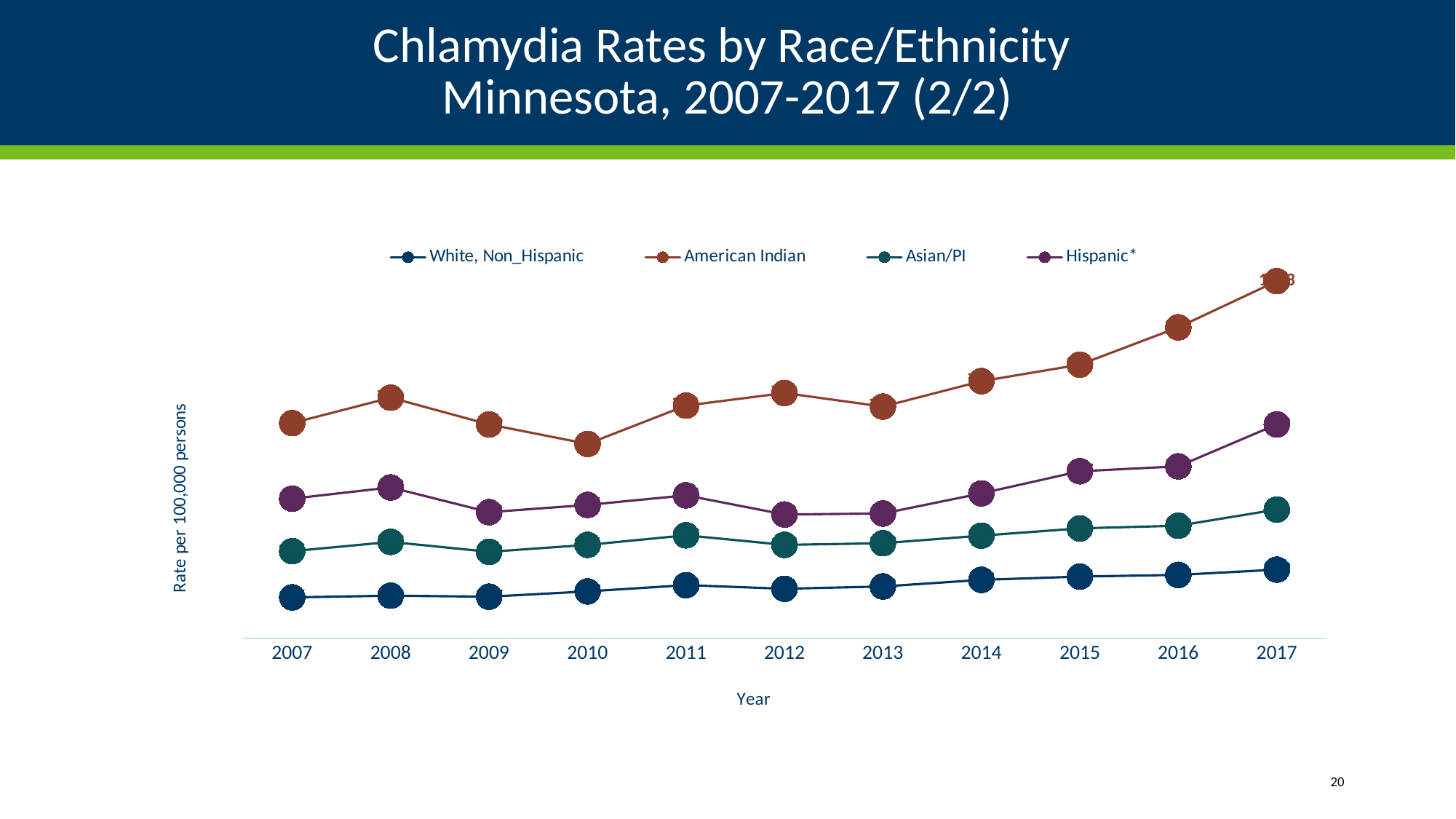
How many series does the legend list? 4 Does the American Indian rate rise or fall from 2013 to 2017? rise Which group has the lowest rate in 2010? White, Non_Hispanic In 2015, is the rate for Hispanic* higher or lower than the rate for Asian/PI? higher Which is larger for American Indian: the rate in 2017 or the rate in 2010? 2017 How many years are plotted along the x axis? 11 Which group has the highest rate in 2007? American Indian Which race/ethnicity group has the lowest chlamydia rate in 2017? White, Non_Hispanic What kind of chart is shown on the slide? line chart Which race/ethnicity group has the highest chlamydia rate in 2017? American Indian What is the label on the y axis? Rate per 100,000 persons What is the title of the chart slide? Chlamydia Rates by Race/Ethnicity Minnesota, 2007-2017 (2/2)